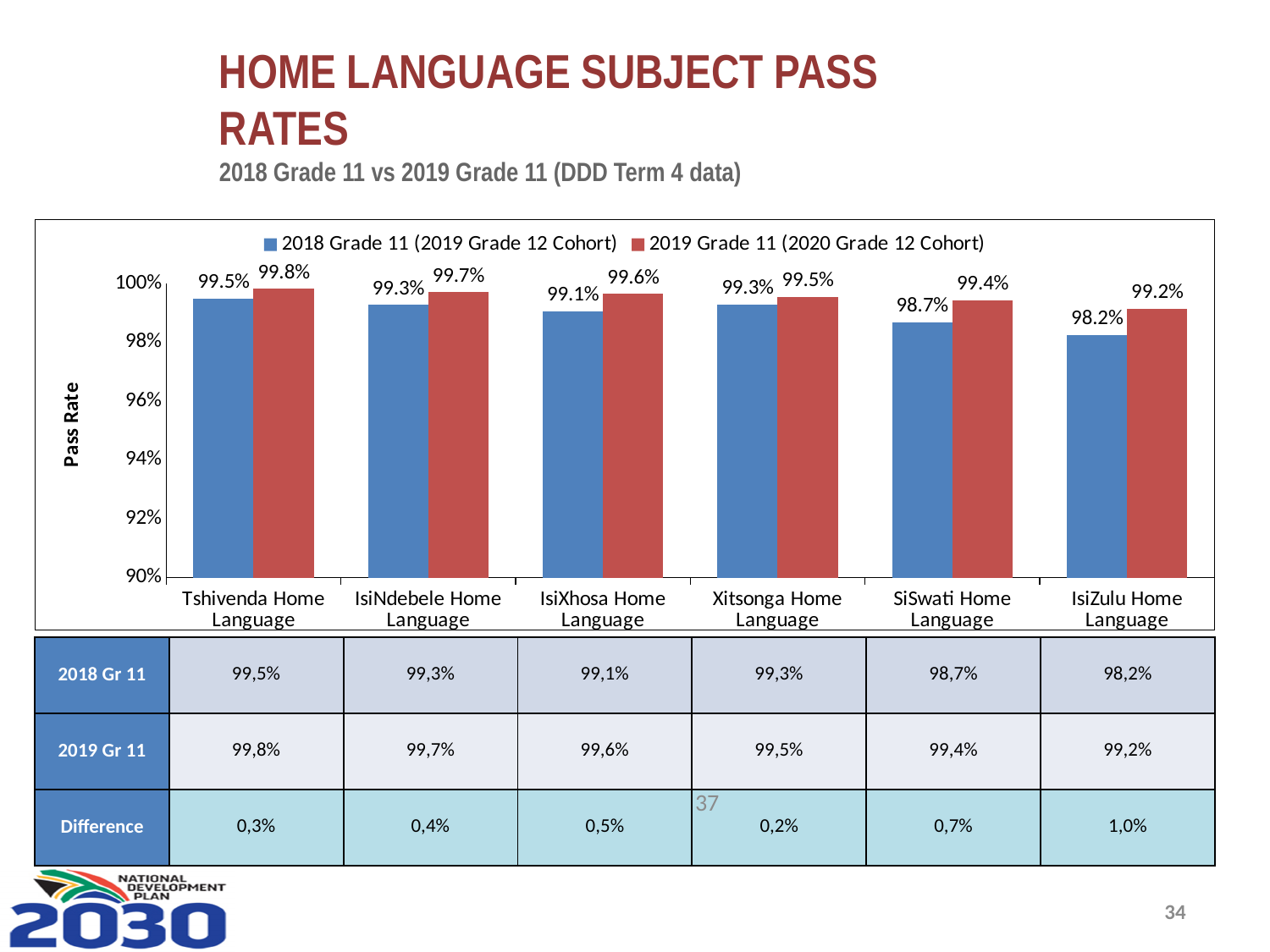
How many series does the chart legend list? 2 What is the difference between the 2019 Grade 11 and 2018 Grade 11 pass rates for IsiZulu Home Language? 1.0% How many home language subjects are shown on the x axis of the chart? 6 What type of chart is shown on the slide? Bar chart What is the difference between the 2019 Grade 11 and 2018 Grade 11 pass rates for SiSwati Home Language? 0.7% Which home language has the lowest 2018 Grade 11 pass rate? IsiZulu Home Language What is the 2019 Grade 11 pass rate for Tshivenda Home Language? 99.8% Which is larger for Xitsonga Home Language: the 2018 Grade 11 pass rate or the 2019 Grade 11 pass rate? 2019 Grade 11 What is the 2019 Grade 11 pass rate for SiSwati Home Language? 99.4% Which home language has the highest 2019 Grade 11 pass rate? Tshivenda Home Language What is the 2018 Grade 11 pass rate for IsiXhosa Home Language? 99.1% What is the label on the vertical axis of the chart? Pass Rate